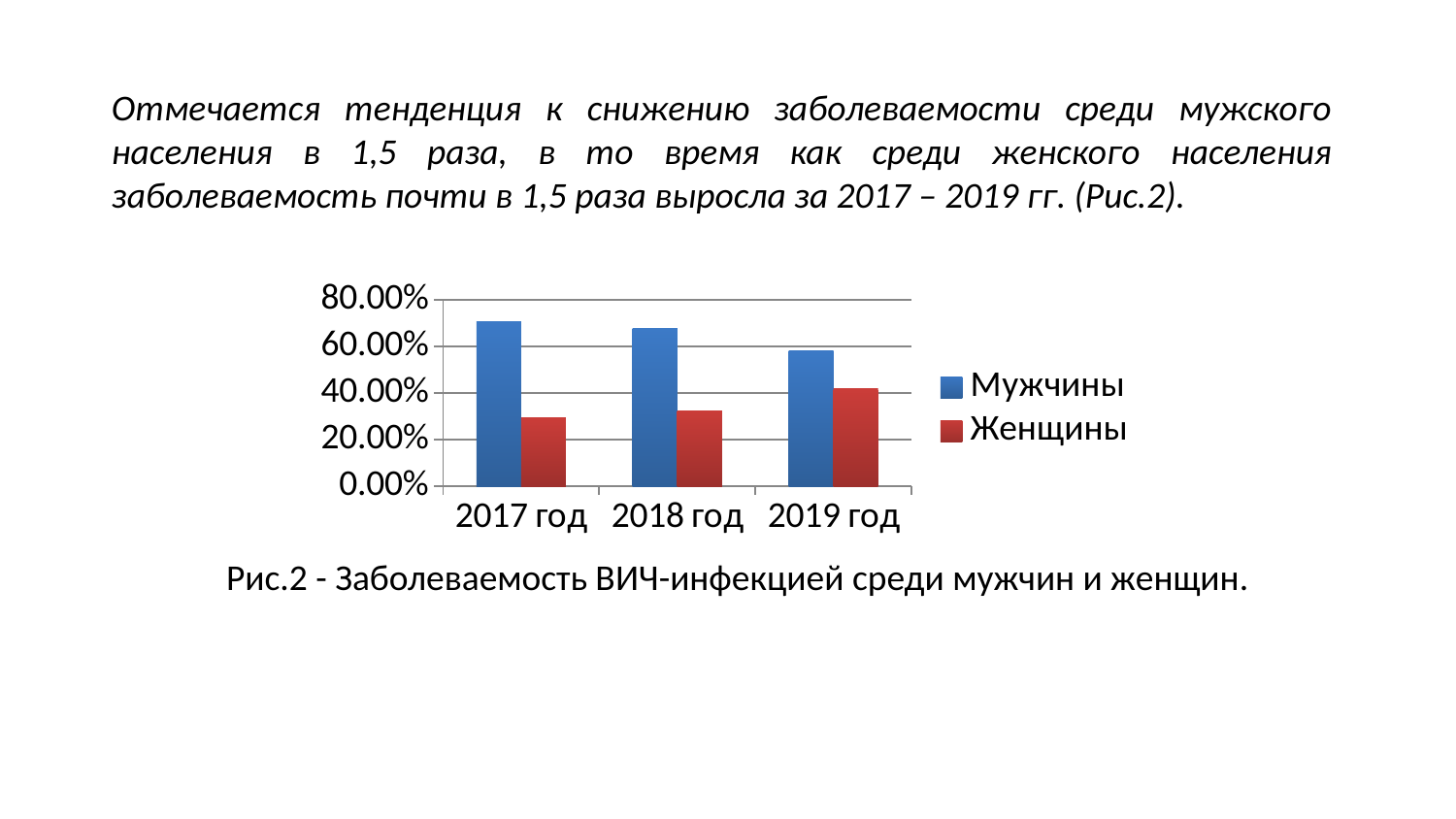
In which year is the value for Женщины the highest? 2019 год Is the value for Мужчины in 2017 год greater or less than 60.00%? greater Which series are listed in the chart legend? Мужчины, Женщины How many series does the chart legend list? 2 How many year categories are shown on the x axis of the chart? 3 What is the caption given below the chart? Рис.2 - Заболеваемость ВИЧ-инфекцией среди мужчин и женщин. Is the value for Женщины in 2017 год greater or less than 40.00%? less What kind of chart is shown on the slide? bar chart In which year is the value for Мужчины the highest? 2017 год In which year is the value for Мужчины the lowest? 2019 год Which series has the larger value in 2019 год, Мужчины or Женщины? Мужчины Is the value for Женщины in 2018 год greater or less than 20.00%? greater